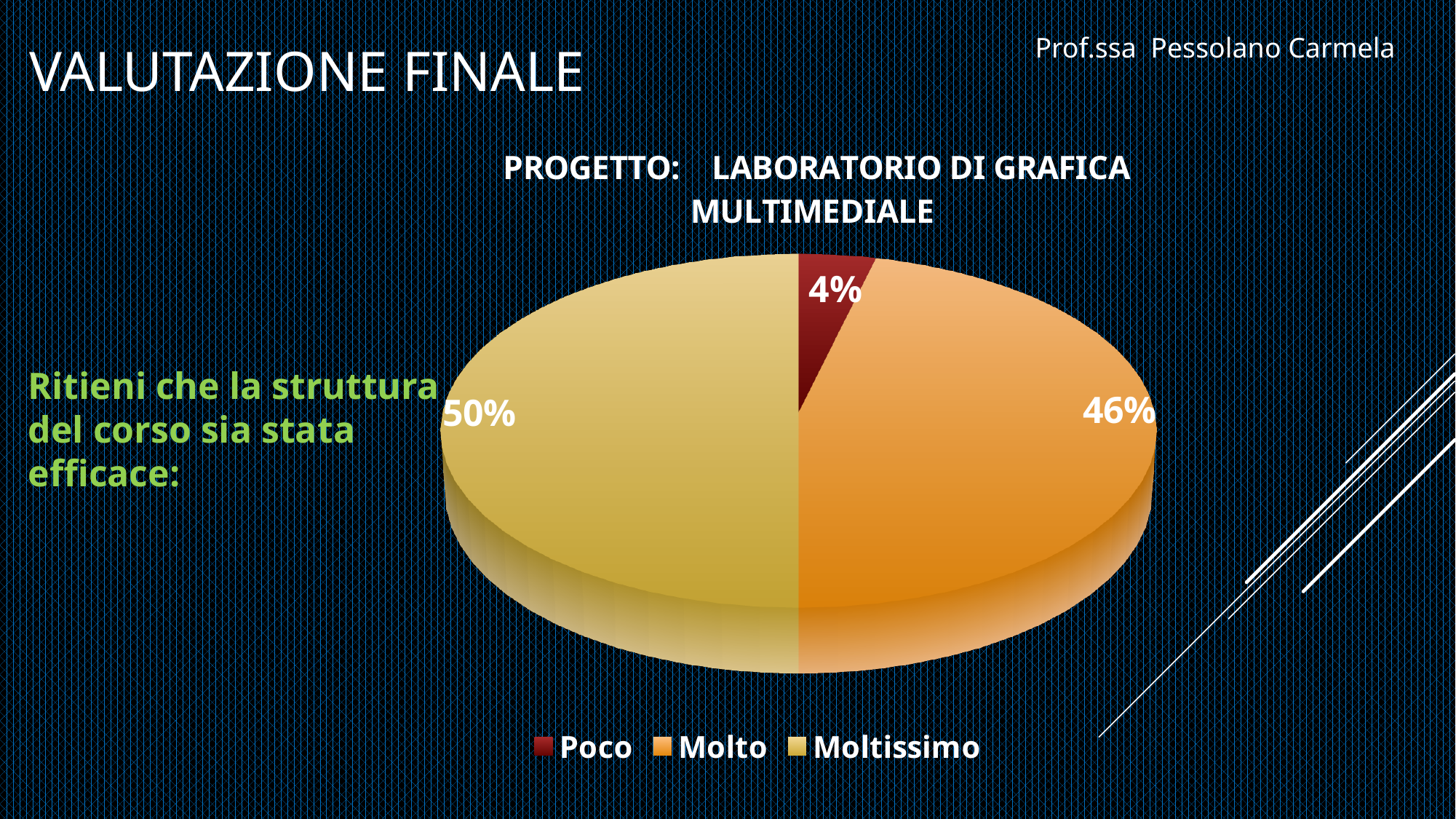
Which colour represents Poco in the legend? Dark red What is the difference in percentage points between Molto and Poco? 42 How many categories does the pie chart show? 3 What kind of chart is shown on the slide? Pie chart What percentage of the pie is labelled Poco? 4% What percentage of the pie is labelled Molto? 46% Which category has the largest share of the pie? Moltissimo Which is larger, the share for Molto or the share for Poco? Molto What is the title of the chart? PROGETTO: LABORATORIO DI GRAFICA MULTIMEDIALE Which category has the smallest share of the pie? Poco What is the difference in percentage points between Moltissimo and Molto? 4 What percentage of the pie is labelled Moltissimo? 50%